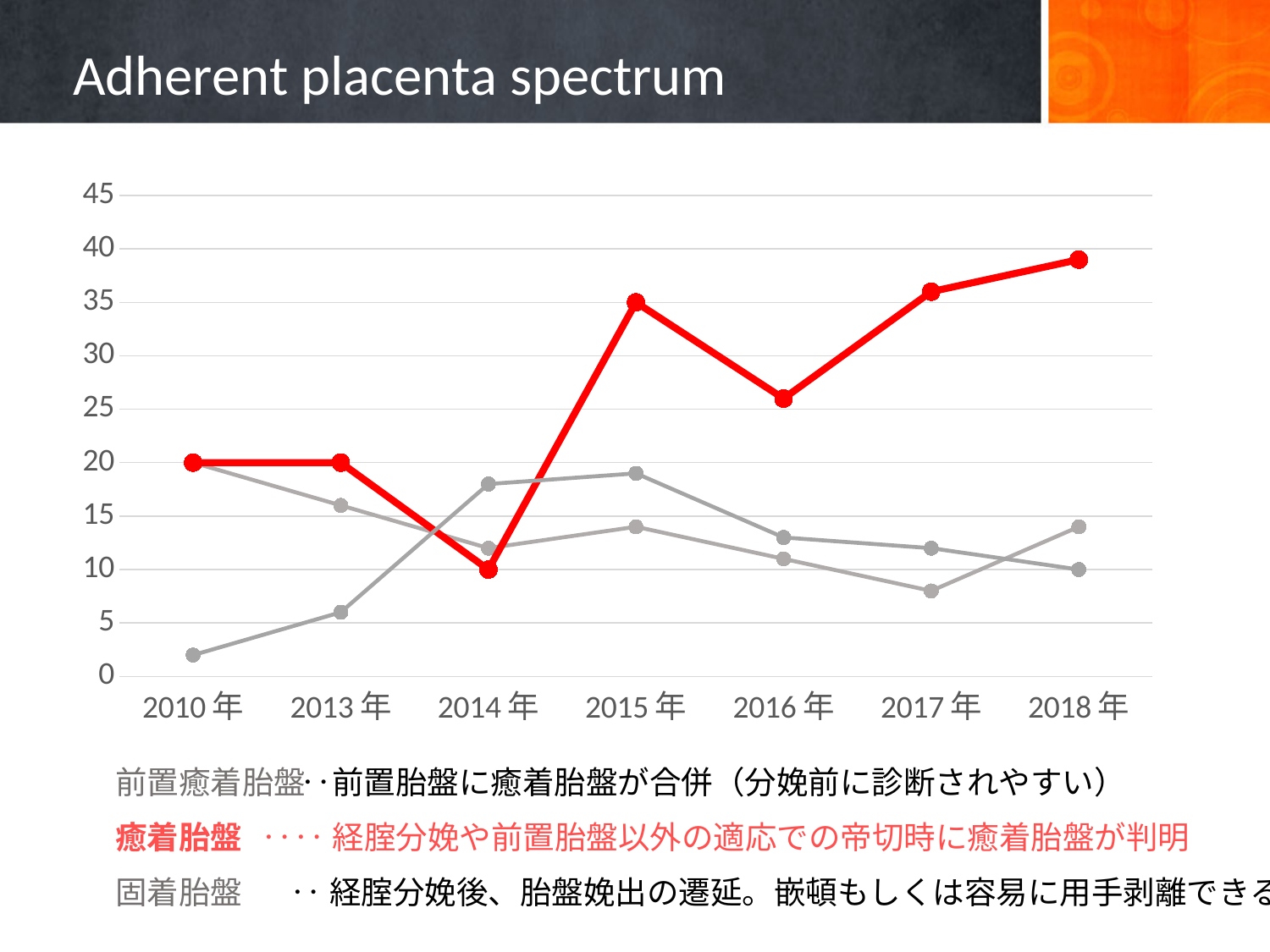
In which year does the red line reach its highest value? 2018年 Is the value of the red line at 2018年 greater or less than 35? greater What is the title of the slide containing the chart? Adherent placenta spectrum What is the value of the red line at 2014年? 10 What is the value of the red line at 2015年? 35 Which is larger for the red line: the value at 2015年 or the value at 2016年? 2015年 Is the value of the red line at 2016年 greater or less than 30? less Does the red line rise or fall from 2016年 to 2018年? rise What is the value of the red line at 2010年? 20 What kind of chart is shown on the slide? line chart In which year does the red line reach its lowest value? 2014年 How many years are shown on the x axis? 7